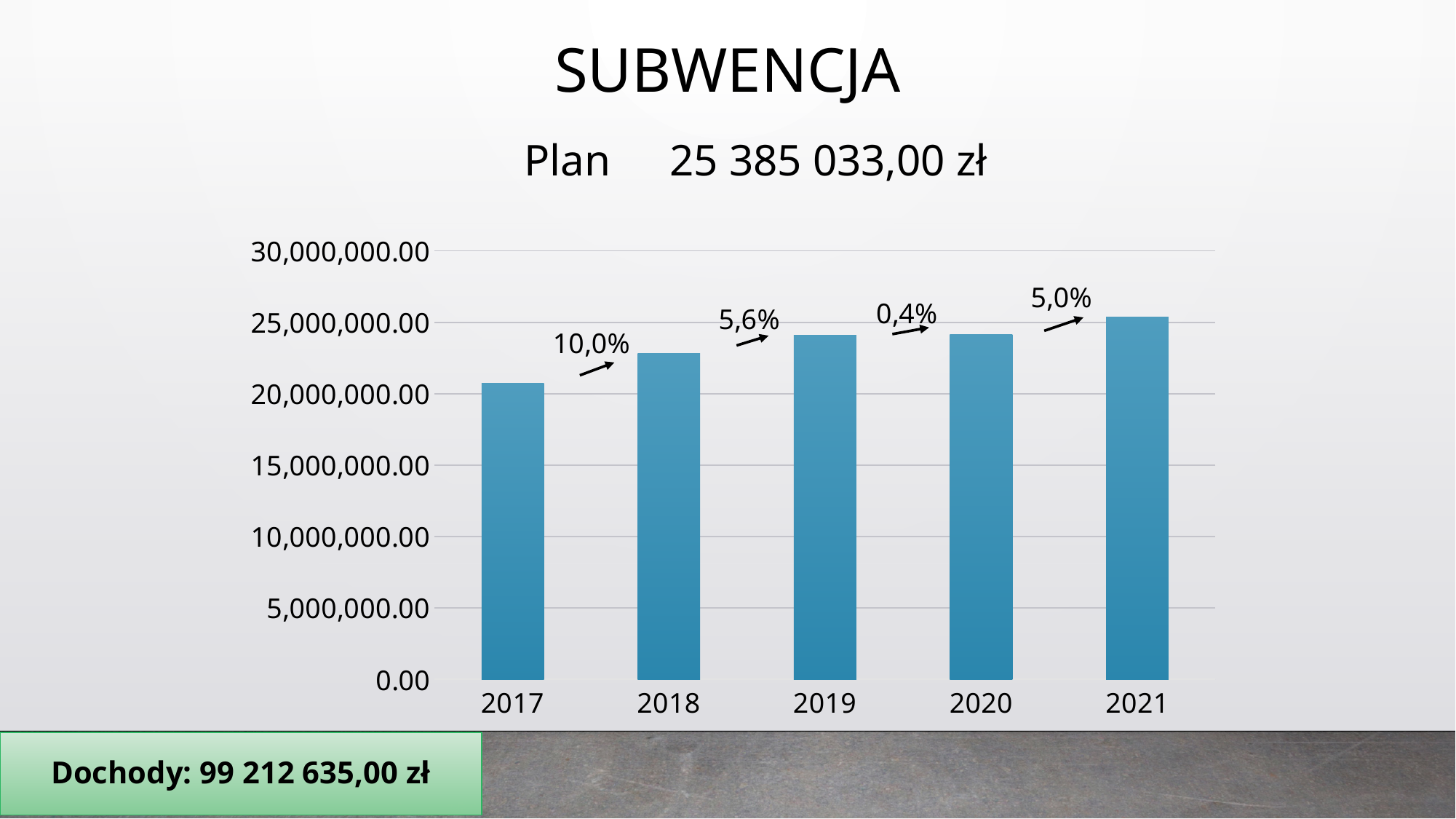
What kind of chart is shown on the slide? bar chart Is the value for 2018 greater or less than 25,000,000.00? less Is the value for 2017 greater or less than 20,000,000.00? greater What percentage change is labelled between the 2019 and 2020 bars? 0,4% Do the values generally rise or fall from 2017 to 2021? rise Is the value for 2019 greater or less than 25,000,000.00? less How many years are shown on the x axis of the chart? 5 What is the title of the chart on the slide? SUBWENCJA Which is larger, the value for 2017 or the value for 2018? 2018 Which year has the lowest bar in the chart? 2017 Which year has the highest bar in the chart? 2021 What percentage change is labelled between the 2017 and 2018 bars? 10,0%